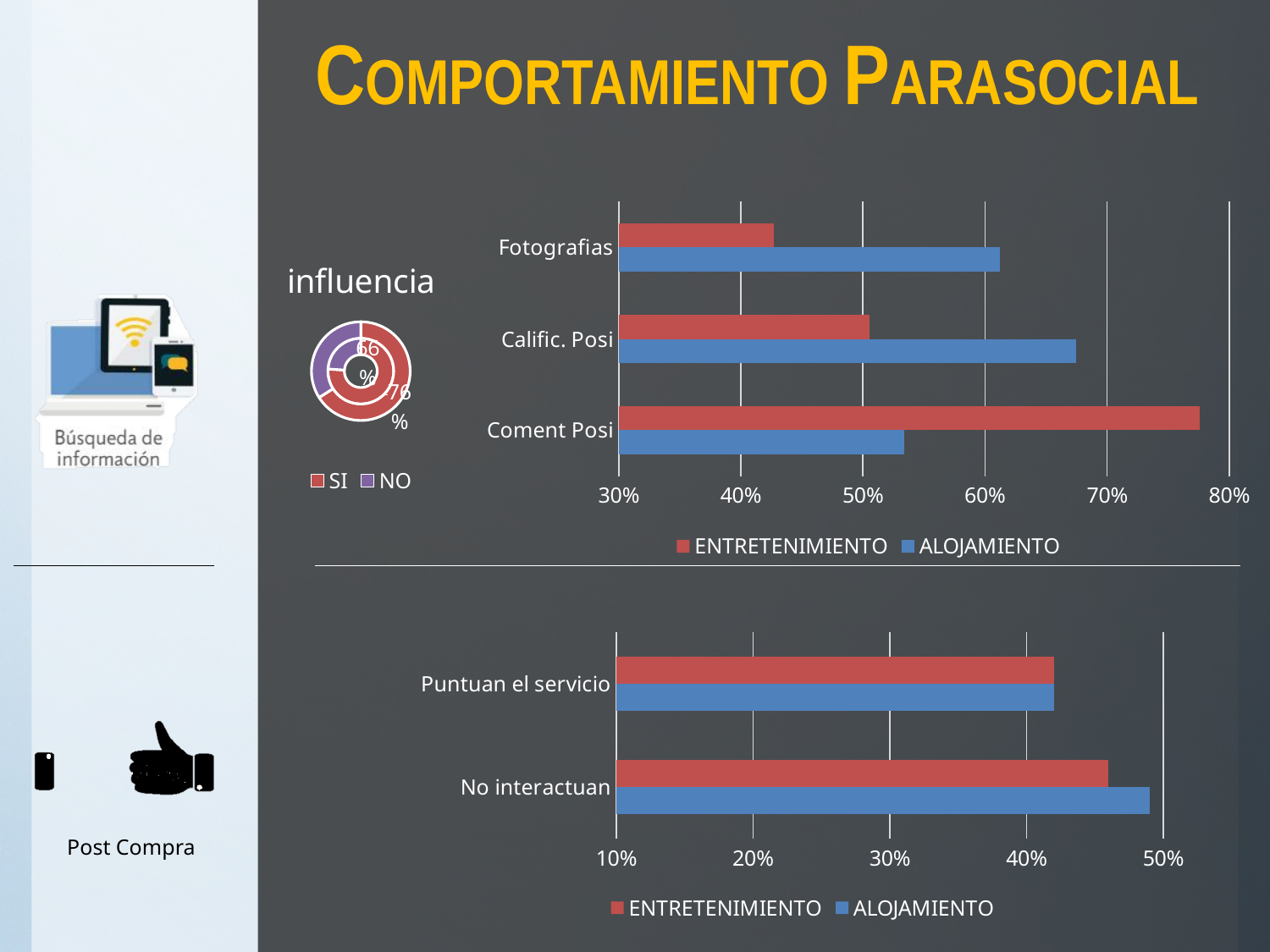
In the bottom bar chart, is the ALOJAMIENTO value for No interactuan greater or less than 40%? greater In the top bar chart, is the ALOJAMIENTO value for Fotografias greater or less than 50%? greater In the top bar chart, is the ENTRETENIMIENTO value for Coment Posi greater or less than 70%? greater In the top bar chart, for Coment Posi, which series has the larger value, ENTRETENIMIENTO or ALOJAMIENTO? ENTRETENIMIENTO What kind of chart is the top chart with Fotografias, Calific. Posi and Coment Posi? bar chart In the top bar chart, how many series does the legend list? 2 In the top bar chart, which category has the highest ENTRETENIMIENTO value? Coment Posi In the top bar chart, for Calific. Posi, which series has the larger value, ENTRETENIMIENTO or ALOJAMIENTO? ALOJAMIENTO In the bottom bar chart, how many categories are shown? 2 What are the two legend entries of the doughnut chart labelled influencia? SI and NO In the top bar chart, how many categories are shown on the vertical axis? 3 In the top bar chart, which category has the lowest ENTRETENIMIENTO value? Fotografias